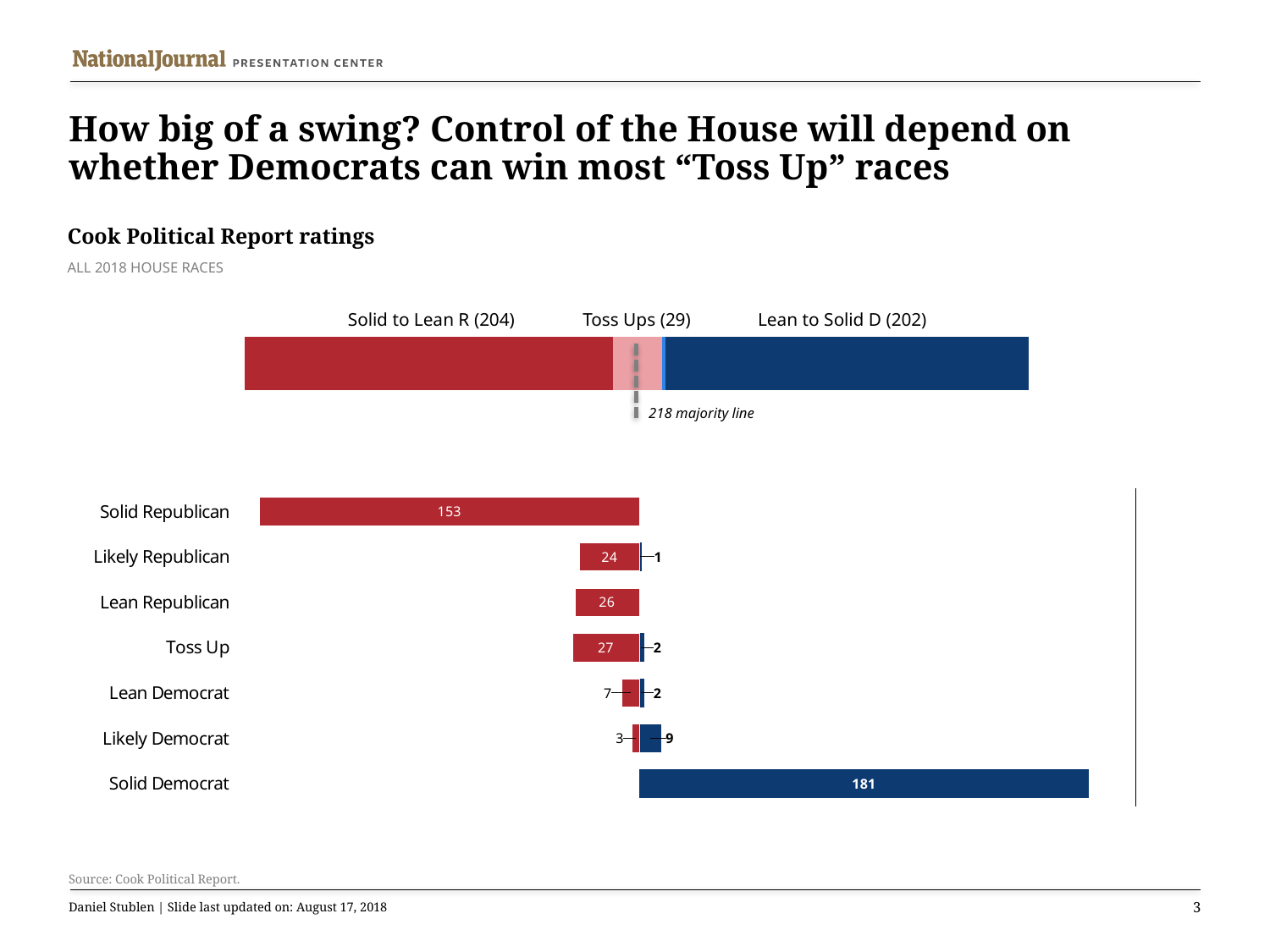
In the bottom bar chart, how many categories are listed? 7 In the bottom bar chart, what is the blue value for Solid Democrat? 181 In the bottom bar chart, what is the blue value for Likely Democrat? 9 In the top stacked bar chart, what majority line is marked? 218 majority line In the bottom bar chart, what is the difference between the Solid Democrat value and the Solid Republican value? 28 In the bottom bar chart, what is the red value for Toss Up? 27 In the bottom bar chart, which category has the largest value? Solid Democrat In the bottom bar chart, what is the red value for Solid Republican? 153 In the top stacked bar chart, what is the value for Lean to Solid D? 202 In the top stacked bar chart, what is the value for Solid to Lean R? 204 In the top stacked bar chart, what is the value for Toss Ups? 29 In the top stacked bar chart, what is the total of the three segments? 435